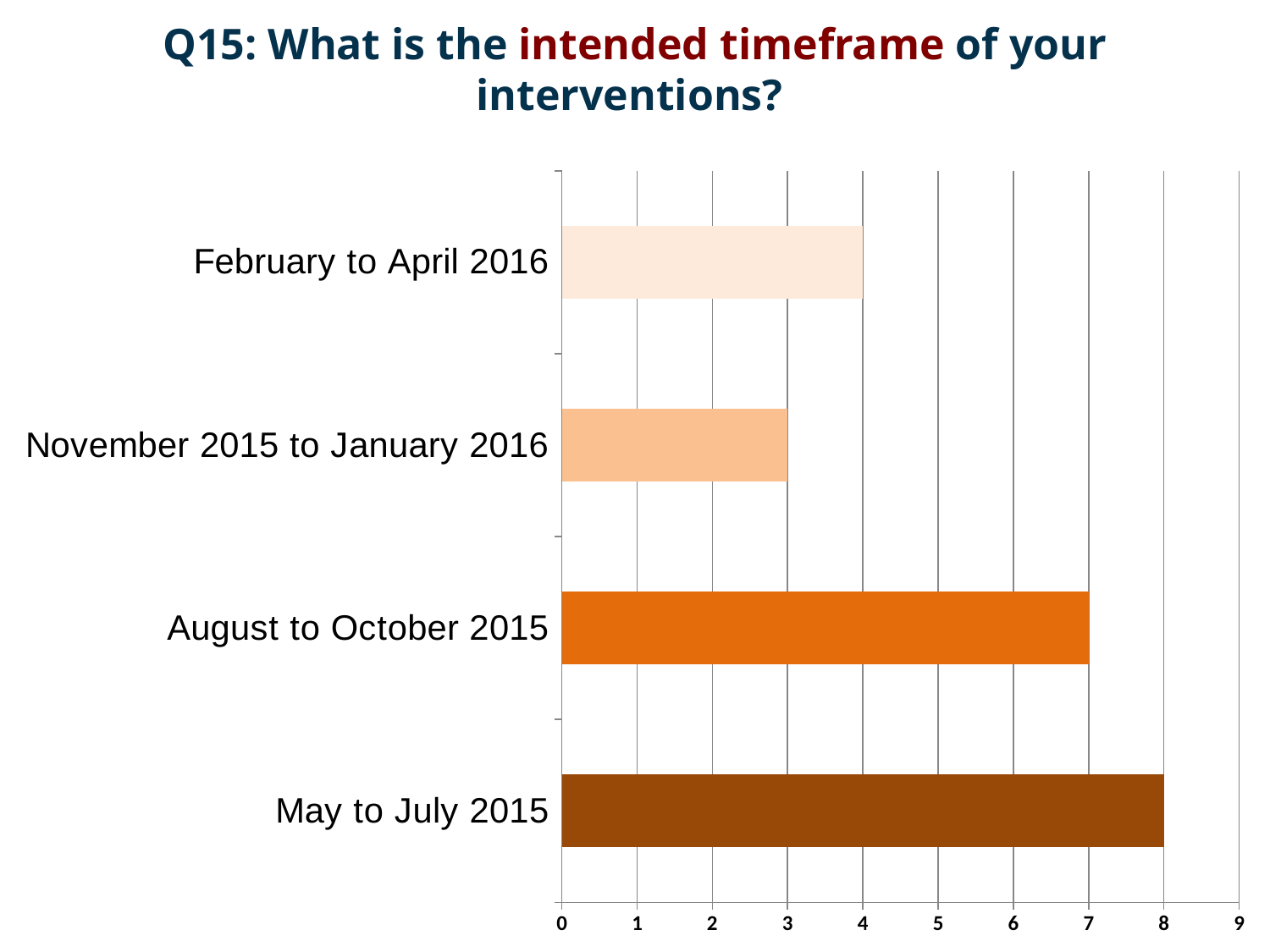
How many timeframe categories are shown in the chart? 4 What is the value for February to April 2016? 4 What is the title of the chart on the slide? Q15: What is the intended timeframe of your interventions? Is the value for August to October 2015 greater or less than 5? greater Which timeframe has the lowest value? November 2015 to January 2016 What is the difference between the values for May to July 2015 and November 2015 to January 2016? 5 What kind of chart is shown on the slide? bar chart What is the value for May to July 2015? 8 Which timeframe has the highest value? May to July 2015 What is the value for November 2015 to January 2016? 3 What is the value for August to October 2015? 7 Which is larger, the value for August to October 2015 or the value for February to April 2016? August to October 2015